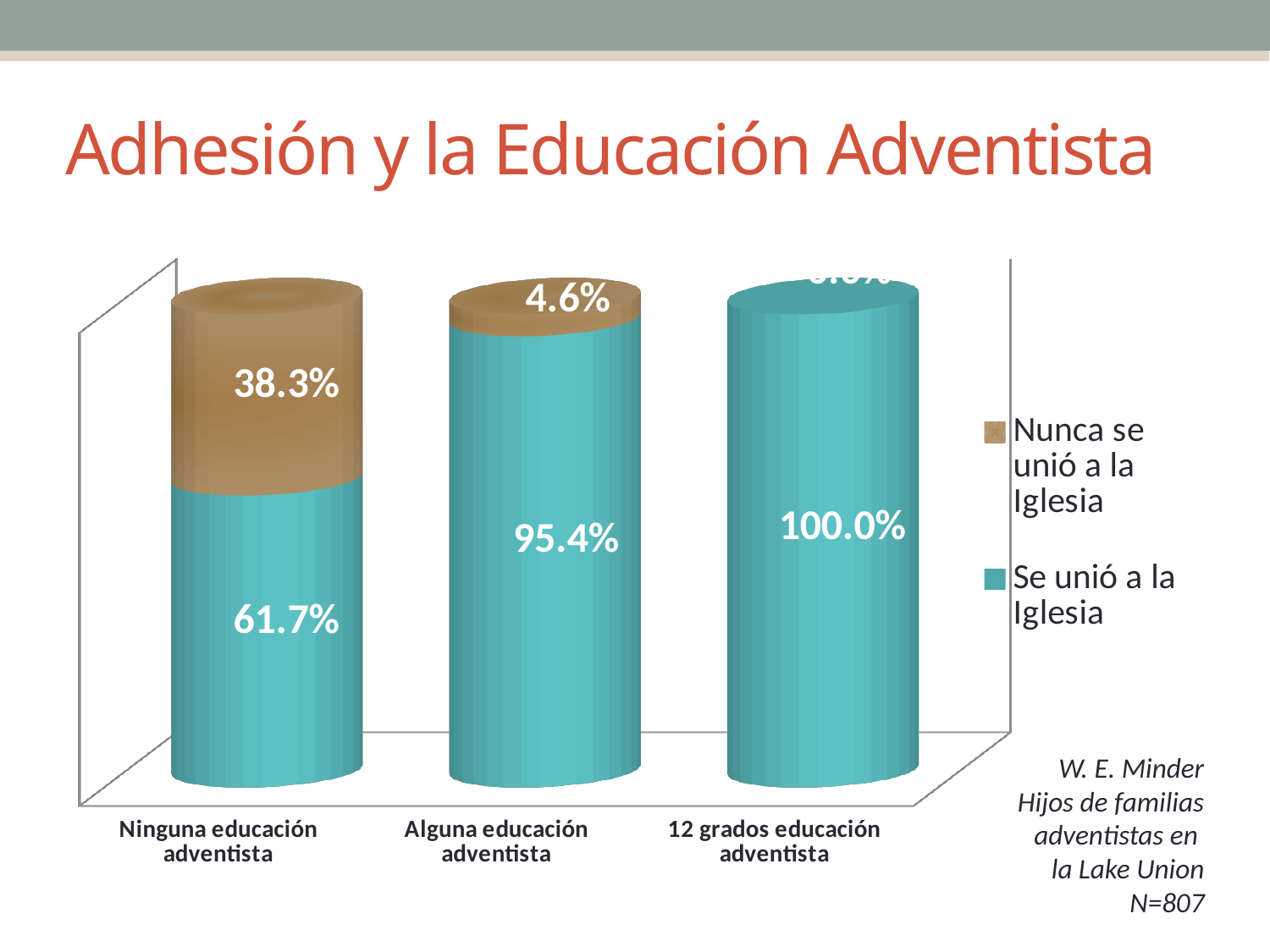
How many categories are shown on the x axis? 3 Which category has the lowest 'Se unió a la Iglesia' value? Ninguna educación adventista Which is larger: the 'Nunca se unió a la Iglesia' value for 'Ninguna educación adventista' or for 'Alguna educación adventista'? Ninguna educación adventista What is the difference between the 'Se unió a la Iglesia' values for 'Alguna educación adventista' and 'Ninguna educación adventista'? 33.7% Which category has the highest 'Se unió a la Iglesia' value? 12 grados educación adventista What is the title of the slide containing the chart? Adhesión y la Educación Adventista What is the 'Se unió a la Iglesia' value for '12 grados educación adventista'? 100.0% What is the 'Se unió a la Iglesia' value for 'Alguna educación adventista'? 95.4% What percentage of those with 'Ninguna educación adventista' never joined the church ('Nunca se unió a la Iglesia')? 38.3% How many series does the legend list? 2 What is the 'Nunca se unió a la Iglesia' value for 'Alguna educación adventista'? 4.6% What percentage of those with 'Ninguna educación adventista' joined the church ('Se unió a la Iglesia')? 61.7%